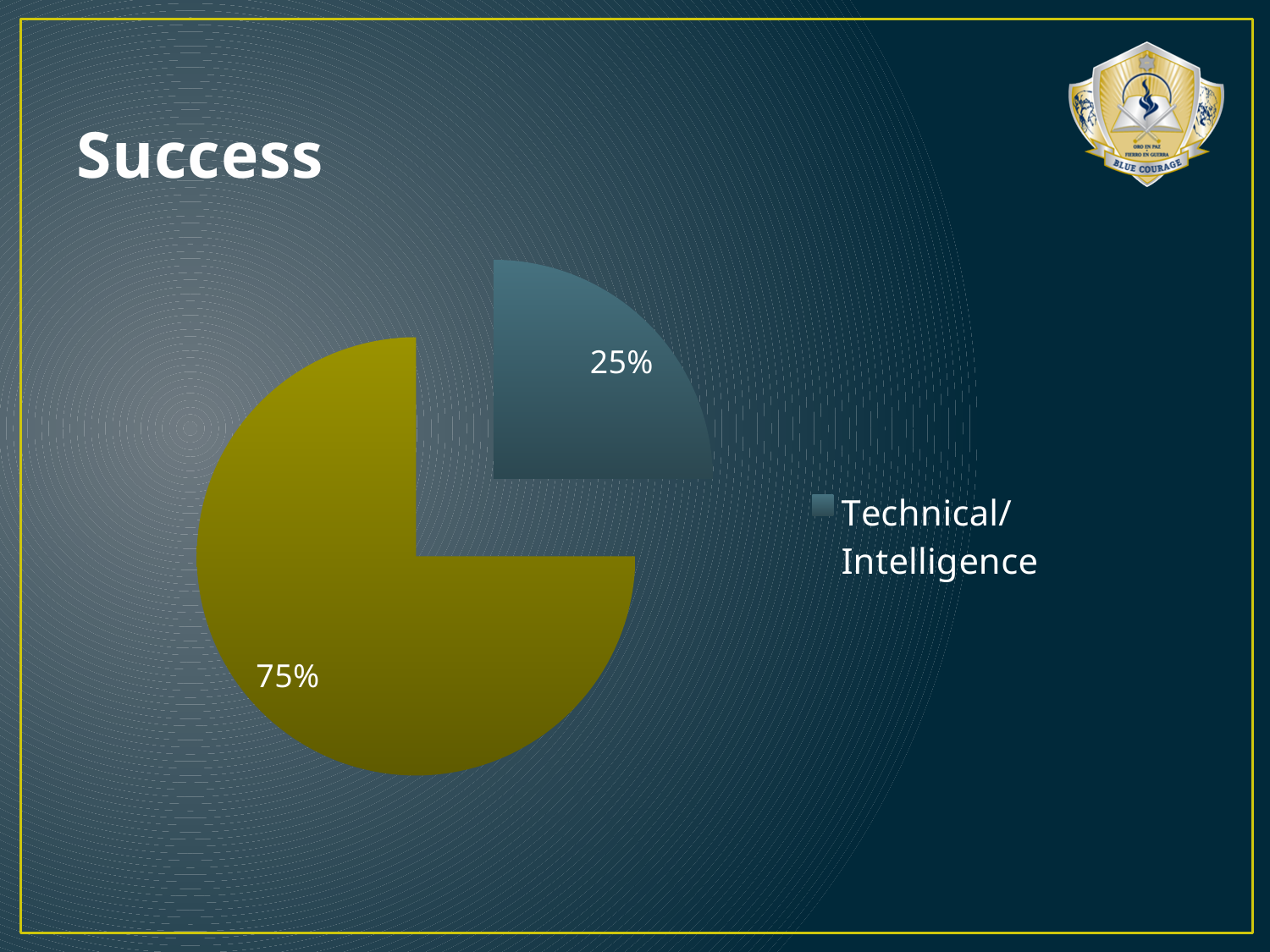
What is the difference in percentage points between the gold slice and the Technical/Intelligence slice? 50 percentage points How many slices does the pie chart have? 2 What percentage is shown on the gold slice of the pie chart? 75% What percentage of the pie does the Technical/Intelligence slice represent? 25% What is the title of the slide containing the pie chart? Success What share of the pie is taken by the Technical/Intelligence slice? 25% Is the Technical/Intelligence slice larger or smaller than the gold slice? Smaller Which slice of the pie chart is the largest? The gold slice (75%) How many entries does the legend of the pie chart list? 1 What kind of chart is shown on the slide? Pie chart Which slice of the pie chart is the smallest? Technical/Intelligence (25%) What colour is the Technical/Intelligence slice in the pie chart? Blue